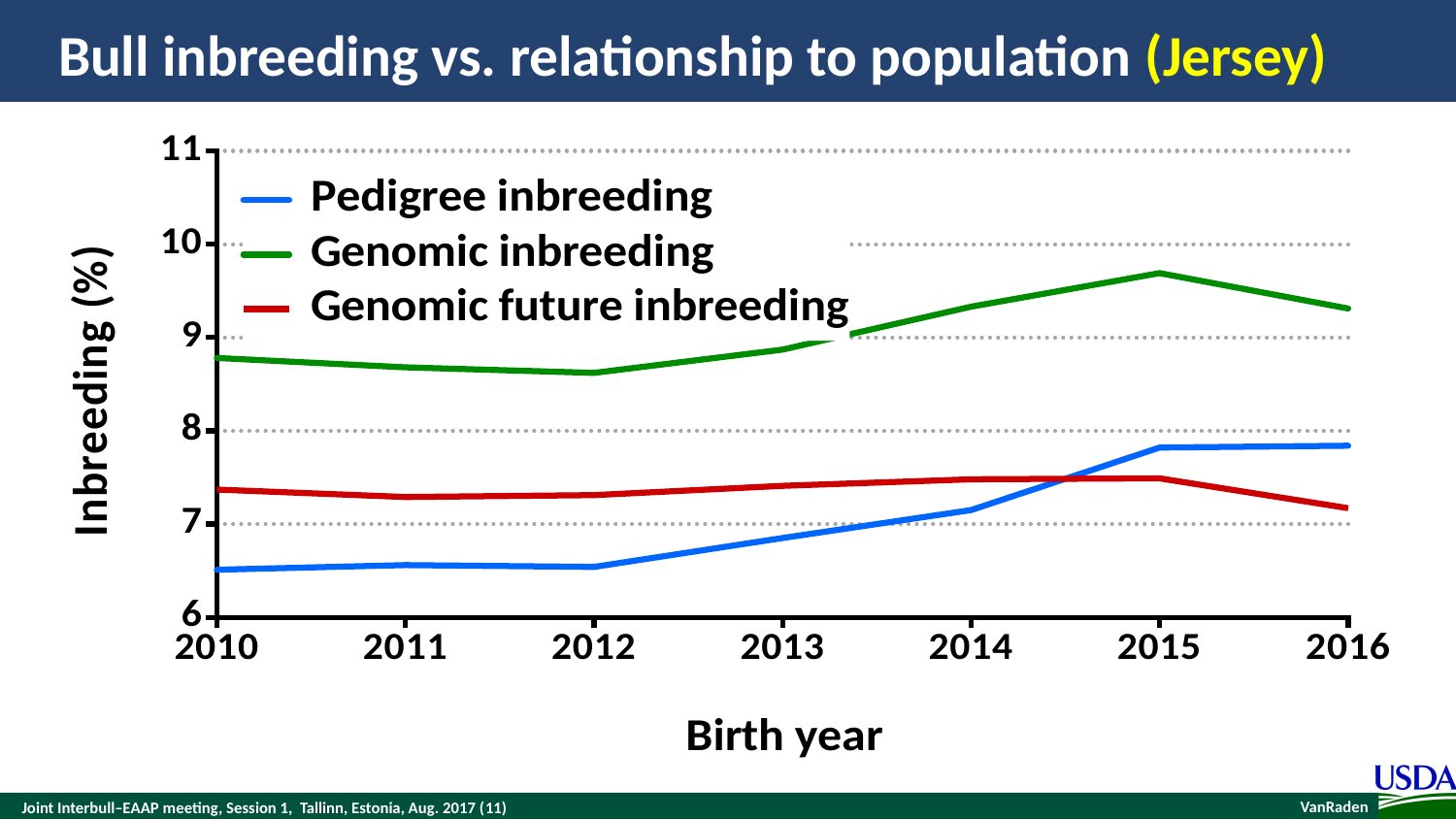
Does Pedigree inbreeding rise or fall from 2010 to 2016? Rise What is the title of the x axis? Birth year Which series has the highest values across all birth years? Genomic inbreeding How many birth years are plotted along the x axis? 7 In 2016, which is larger: Pedigree inbreeding or Genomic future inbreeding? Pedigree inbreeding Is the Pedigree inbreeding value for 2010 greater or less than 7? less Is the Pedigree inbreeding value for 2016 greater or less than 8? less What kind of chart is shown on the slide? Line chart Is the Genomic inbreeding value for 2015 greater or less than 9? greater In which birth year is Genomic inbreeding lowest? 2012 How many series does the legend list? 3 In which birth year is Genomic inbreeding highest? 2015